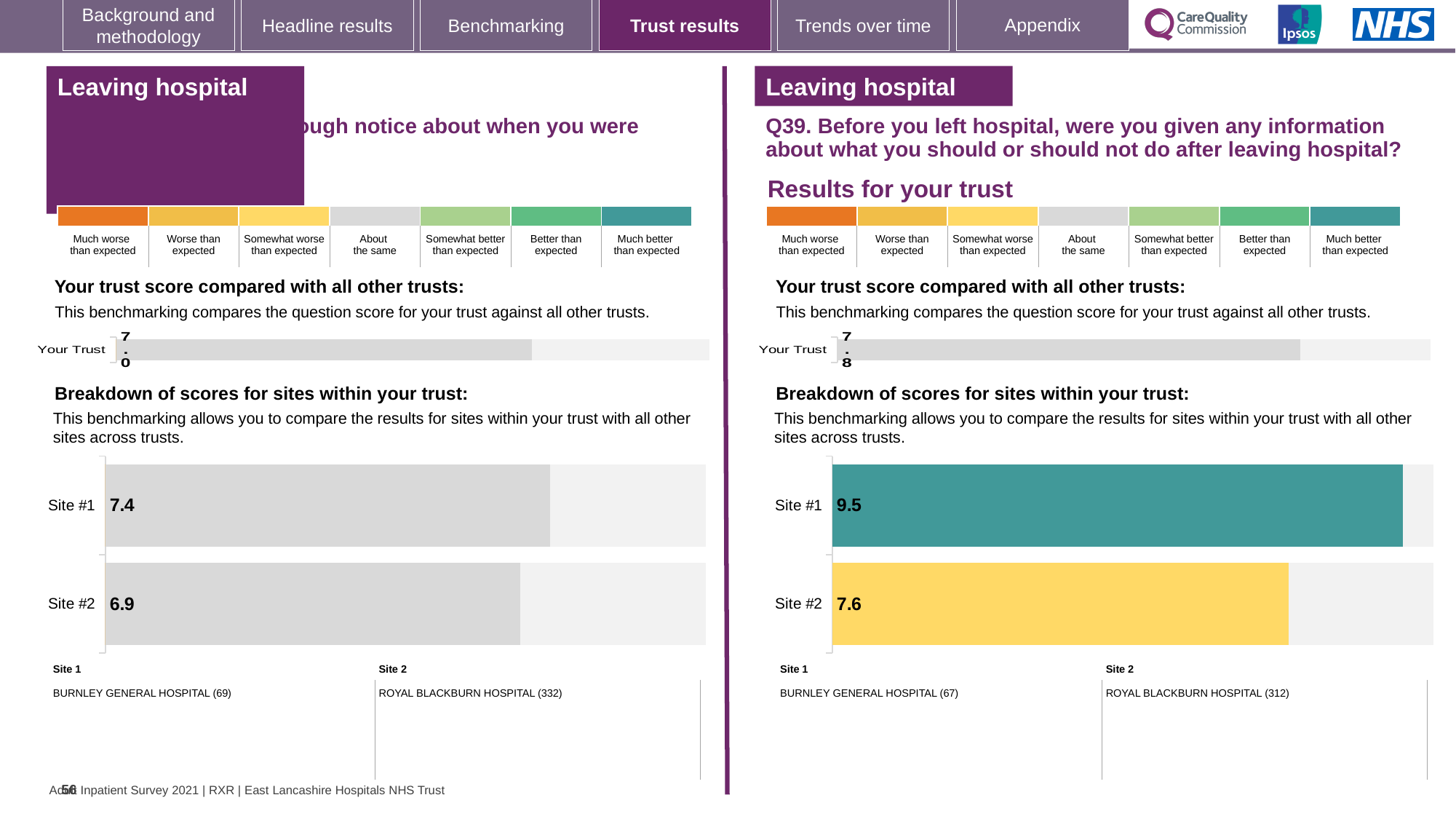
On the left-hand site breakdown chart, which site has the lower score? Site #2 What kind of chart is the right-hand (Q39) 'Breakdown of scores for sites within your trust' chart? Bar chart How many sites are shown on the right-hand (Q39) site breakdown chart? 2 On the right-hand (Q39) 'Breakdown of scores for sites within your trust' chart, what is the score for Site #1? 9.5 On the right-hand (Q39) 'Breakdown of scores for sites within your trust' chart, what is the score for Site #2? 7.6 On the left-hand 'Your trust score compared with all other trusts' chart, what is the score for Your Trust? 7.0 On the left-hand site breakdown chart, what is the difference between the Site #1 and Site #2 scores? 0.5 On the left-hand 'Breakdown of scores for sites within your trust' chart, what is the score for Site #2? 6.9 On the right-hand (Q39) site breakdown chart, what is the difference between the Site #1 and Site #2 scores? 1.9 On the left-hand 'Breakdown of scores for sites within your trust' chart, what is the score for Site #1? 7.4 On the right-hand (Q39) 'Your trust score compared with all other trusts' chart, what is the score for Your Trust? 7.8 On the right-hand (Q39) site breakdown chart, which site has the higher score? Site #1